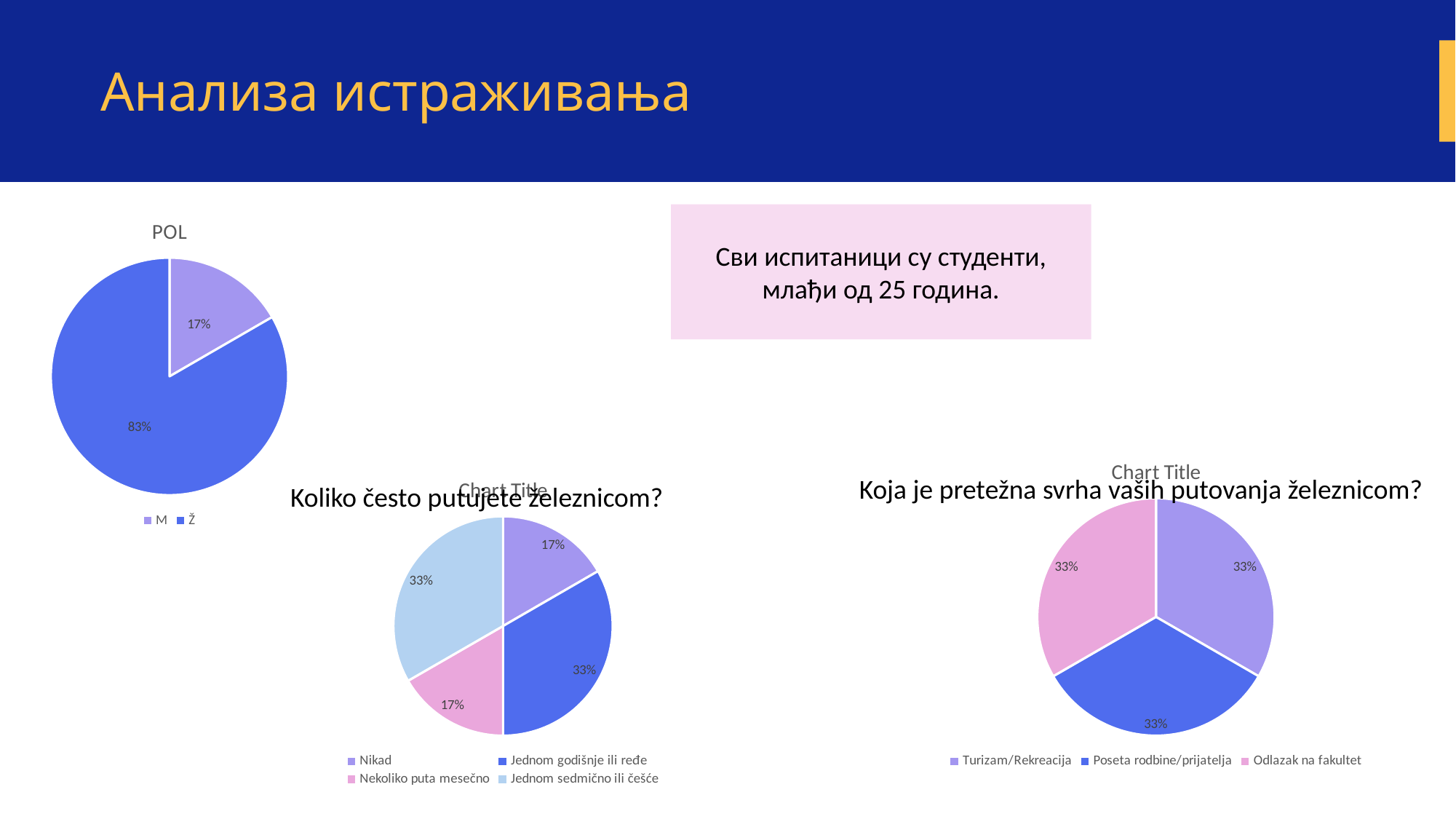
In the top-left chart titled POL, which category has the largest slice? Ž In the bottom-middle chart (Koliko često putujete železnicom?), what share is labelled Jednom sedmično ili češće? 33% What kind of chart is the top-left chart titled POL? Pie chart In the bottom-right chart (Koja je pretežna svrha vaših putovanja železnicom?), what share is labelled Odlazak na fakultet? 33% In the bottom-right chart (Koja je pretežna svrha vaših putovanja železnicom?), which legend entry is shown in pink? Odlazak na fakultet In the top-left chart titled POL, what share of the pie is labelled Ž? 83% How many categories does the legend of the bottom-middle chart (Koliko često putujete železnicom?) list? 4 How many categories does the legend of the bottom-right chart (Koja je pretežna svrha vaših putovanja železnicom?) list? 3 In the bottom-middle chart (Koliko često putujete železnicom?), which is larger: Nikad or Jednom godišnje ili ređe? Jednom godišnje ili ređe In the top-left chart titled POL, what is the difference between the Ž and M shares? 66%